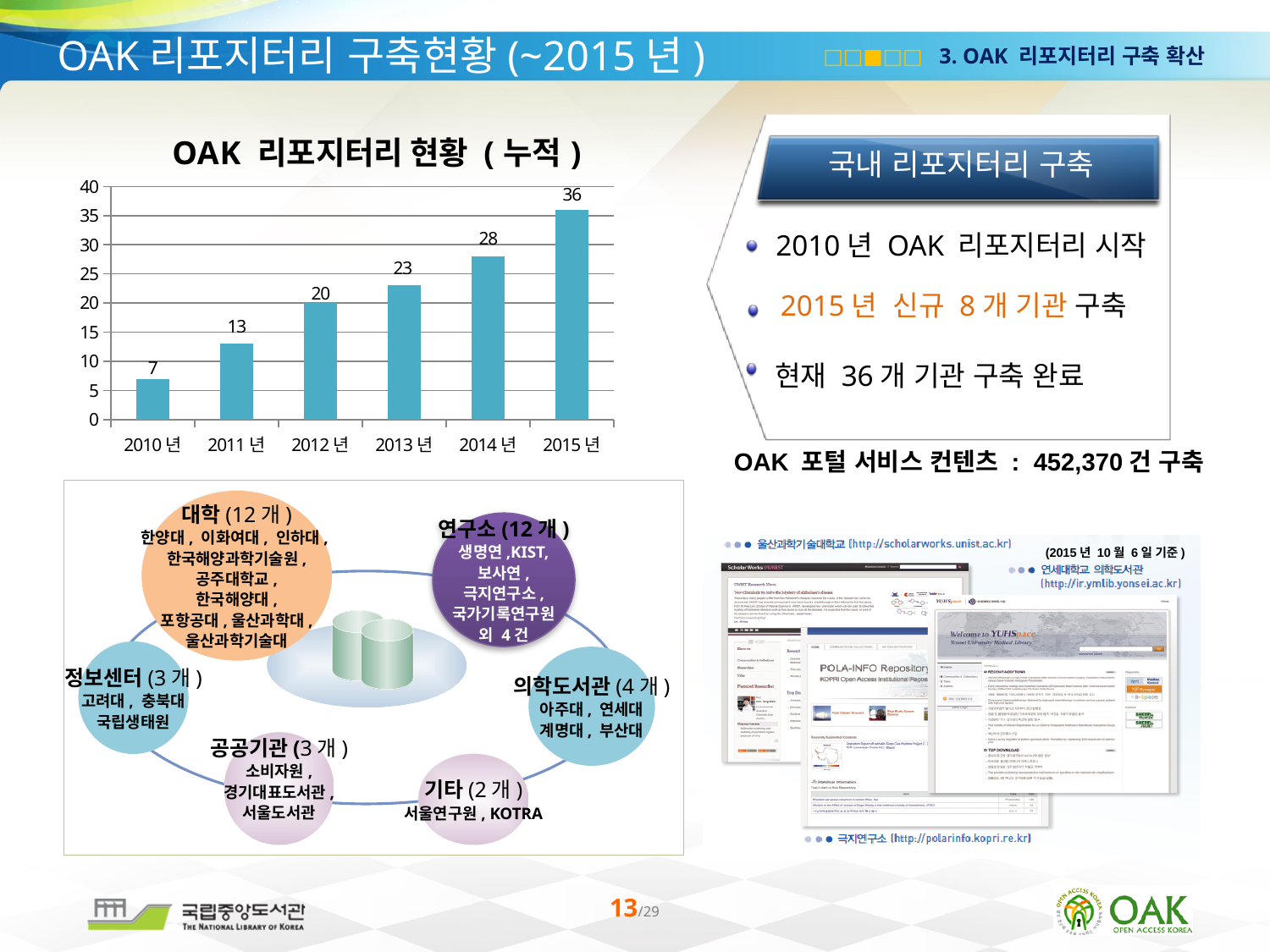
What is the value for 2015 년 in the OAK 리포지터리 현황 (누적) chart? 36 Do the values in the OAK 리포지터리 현황 (누적) chart rise or fall from 2010 년 to 2015 년? rise Which year has the lowest value in the OAK 리포지터리 현황 (누적) chart? 2010 년 What is the value for 2013 년 in the OAK 리포지터리 현황 (누적) chart? 23 What kind of chart is the OAK 리포지터리 현황 (누적) chart? bar chart How many years are shown on the x axis of the OAK 리포지터리 현황 (누적) chart? 6 Is the value for 2014 년 in the OAK 리포지터리 현황 (누적) chart greater or less than 25? greater What is the value for 2010 년 in the OAK 리포지터리 현황 (누적) chart? 7 Which is larger in the OAK 리포지터리 현황 (누적) chart, the value for 2011 년 or the value for 2013 년? 2013 년 Which year has the highest value in the OAK 리포지터리 현황 (누적) chart? 2015 년 What is the difference between the values for 2012 년 and 2011 년 in the OAK 리포지터리 현황 (누적) chart? 7 What is the difference between the values for 2015 년 and 2014 년 in the OAK 리포지터리 현황 (누적) chart? 8